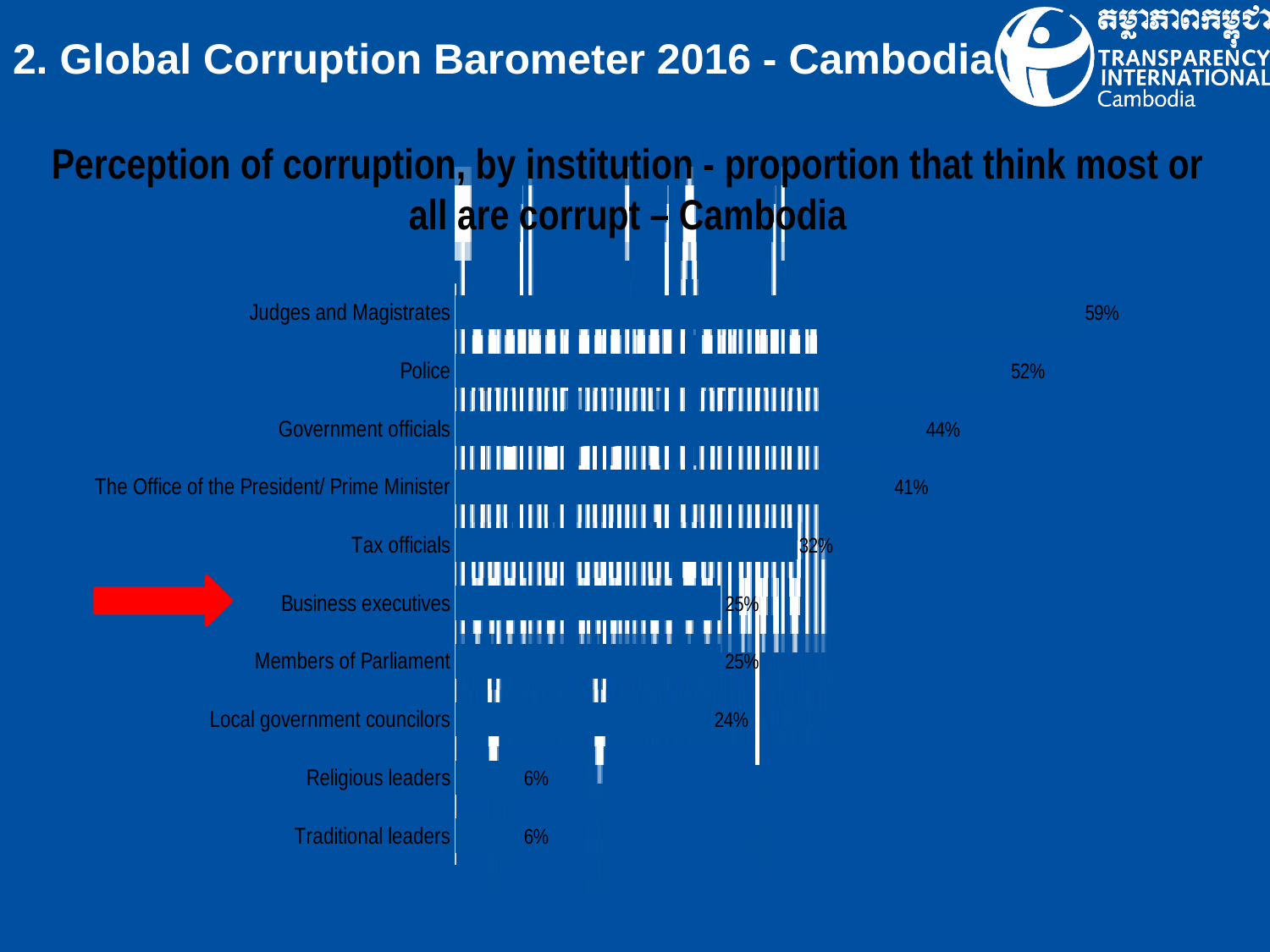
How many institutions are listed on the chart? 10 What is the lowest value shown on the chart? 6% What is the value shown for The Office of the President/ Prime Minister? 41% What is the difference between the values for Judges and Magistrates and Police? 7% What is the value shown for Police? 52% What type of chart is shown on the slide? Bar chart Which institution has the highest proportion of respondents who think most or all are corrupt? Judges and Magistrates What is the value shown for Government officials? 44% What percentage of respondents think most or all Judges and Magistrates are corrupt? 59% What is the difference between the values for Tax officials and Business executives? 7% Which has a higher value, Government officials or Tax officials? Government officials What is the value shown for Local government councilors? 24%